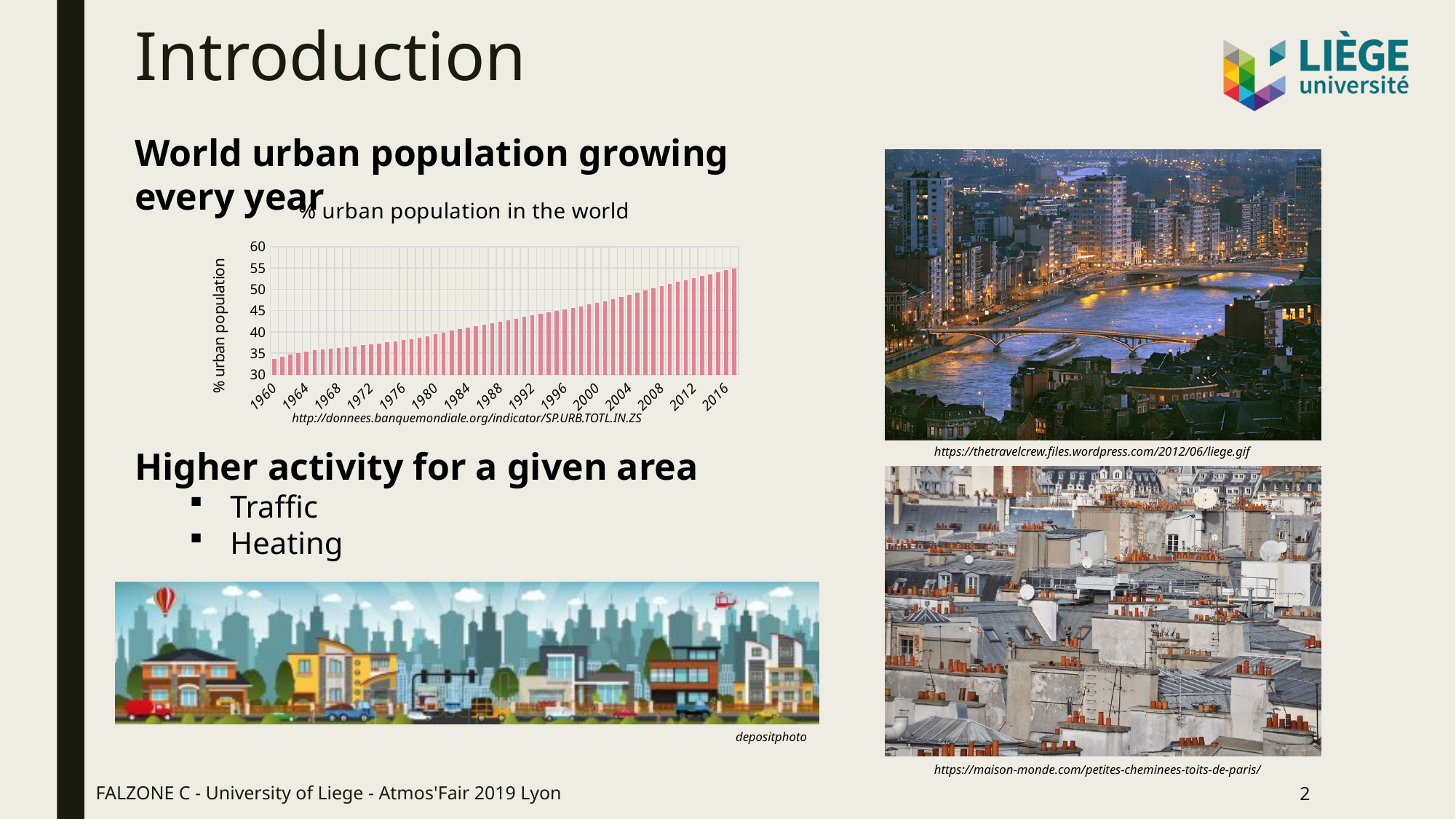
Which year has the larger value, 1960 or 2016? 2016 Is the value for 1972 greater or less than 40? less Which year has the lowest value in the chart? 1960 Is the value for 2000 greater or less than 45? greater What kind of chart is shown on the slide? bar chart How many year labels are shown on the x axis of the chart? 15 Is the value for 2016 greater or less than 50? greater What is the title of the chart? % urban population in the world What is the label on the vertical axis of the chart? % urban population Do the values in the chart rise or fall from 1960 to 2016? rise